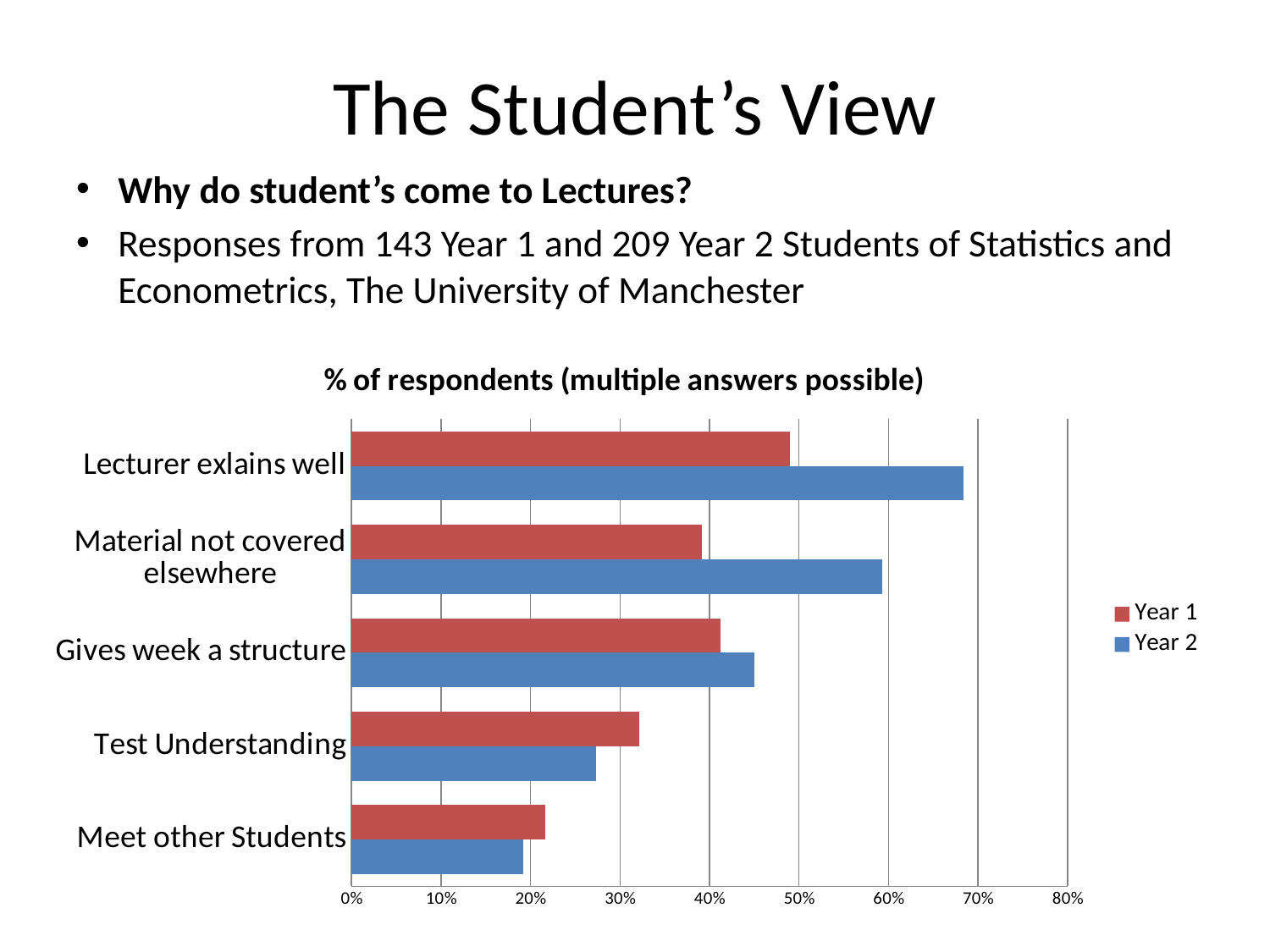
For Lecturer exlains well, which series has the larger value, Year 1 or Year 2? Year 2 How many categories are shown on the chart? 5 Which category has the lowest value for Year 2? Meet other Students Which category has the highest value for Year 2? Lecturer exlains well How many series does the legend list? 2 Is the Year 2 value for Test Understanding greater or less than 30%? less What kind of chart is shown on the slide? bar chart Is the Year 2 value for Lecturer exlains well greater or less than 60%? greater What is the title of the chart? % of respondents (multiple answers possible) For Test Understanding, which series has the larger value, Year 1 or Year 2? Year 1 Is the Year 2 value for Material not covered elsewhere greater or less than 50%? greater Which category has the lowest value for Year 1? Meet other Students